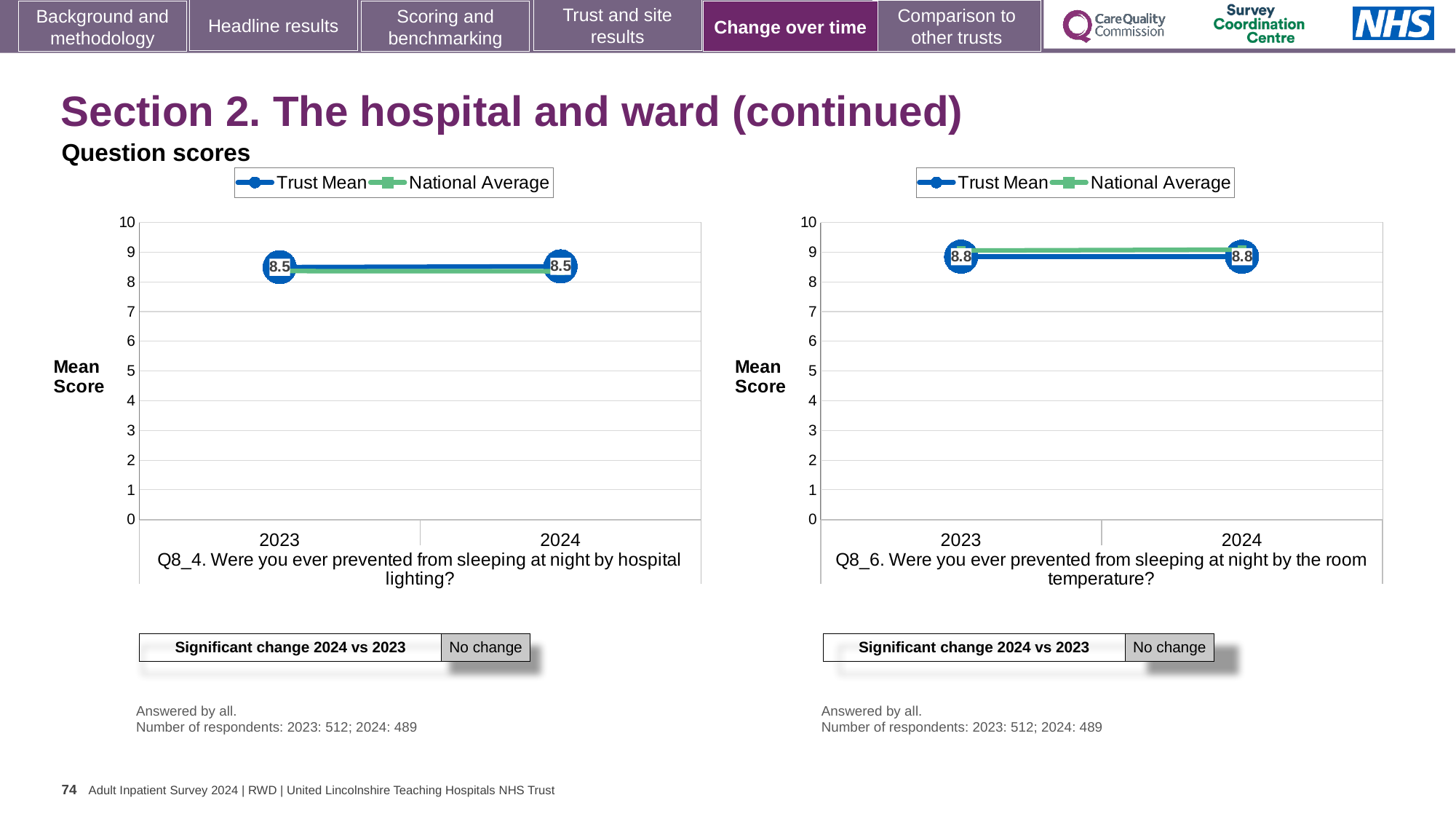
In the left chart (Q8_4, hospital lighting), what is the Trust Mean score for 2023? 8.5 In the right chart (Q8_6, room temperature), what is the Trust Mean score for 2024? 8.8 How many series does the legend of the right chart (Q8_6) list? 2 What kind of chart is the left chart (Q8_4)? line chart In the right chart (Q8_6), does the Trust Mean rise, fall or stay the same from 2023 to 2024? stays the same In the left chart (Q8_4), is the National Average value for 2023 greater or less than 7? greater What are the two series named in the legend of the left chart (Q8_4)? Trust Mean and National Average In the right chart (Q8_6), is the National Average value for 2024 greater or less than 8? greater In the right chart (Q8_6, room temperature), what is the Trust Mean score for 2023? 8.8 How many years are shown on the x axis of the left chart (Q8_4)? 2 In the left chart (Q8_4, hospital lighting), what is the Trust Mean score for 2024? 8.5 In the left chart (Q8_4), what is the difference between the Trust Mean scores for 2024 and 2023? 0